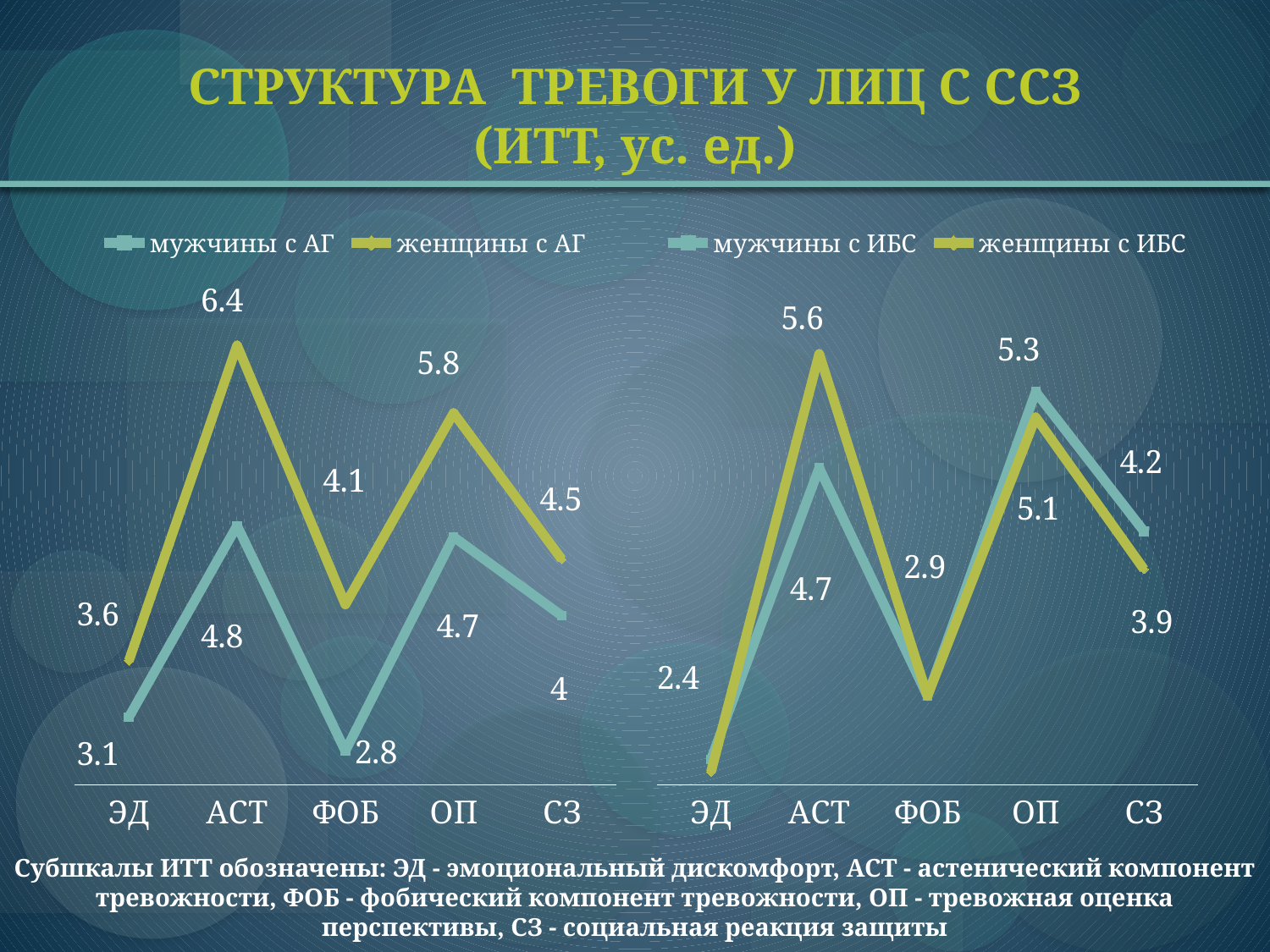
In the left chart, what is the difference between женщины с АГ and мужчины с АГ at АСТ? 1.6 In the right chart, what is the value for женщины с ИБС at АСТ? 5.6 In the right chart, at which subscale is the value for женщины с ИБС highest? АСТ In the left chart, what is the value for женщины с АГ at АСТ? 6.4 In the left chart, at which subscale is the value for женщины с АГ highest? АСТ In the right chart, what is the value for мужчины с ИБС at ОП? 5.3 In the left chart, at which subscale is the value for мужчины с АГ lowest? ФОБ What kind of chart is the left chart (мужчины с АГ / женщины с АГ)? line chart In the left chart, what is the value for мужчины с АГ at ФОБ? 2.8 How many series does the legend of the right chart list? 2 In the right chart, which series has the larger value at СЗ, мужчины с ИБС or женщины с ИБС? мужчины с ИБС How many subscales are shown on the x axis of the left chart? 5